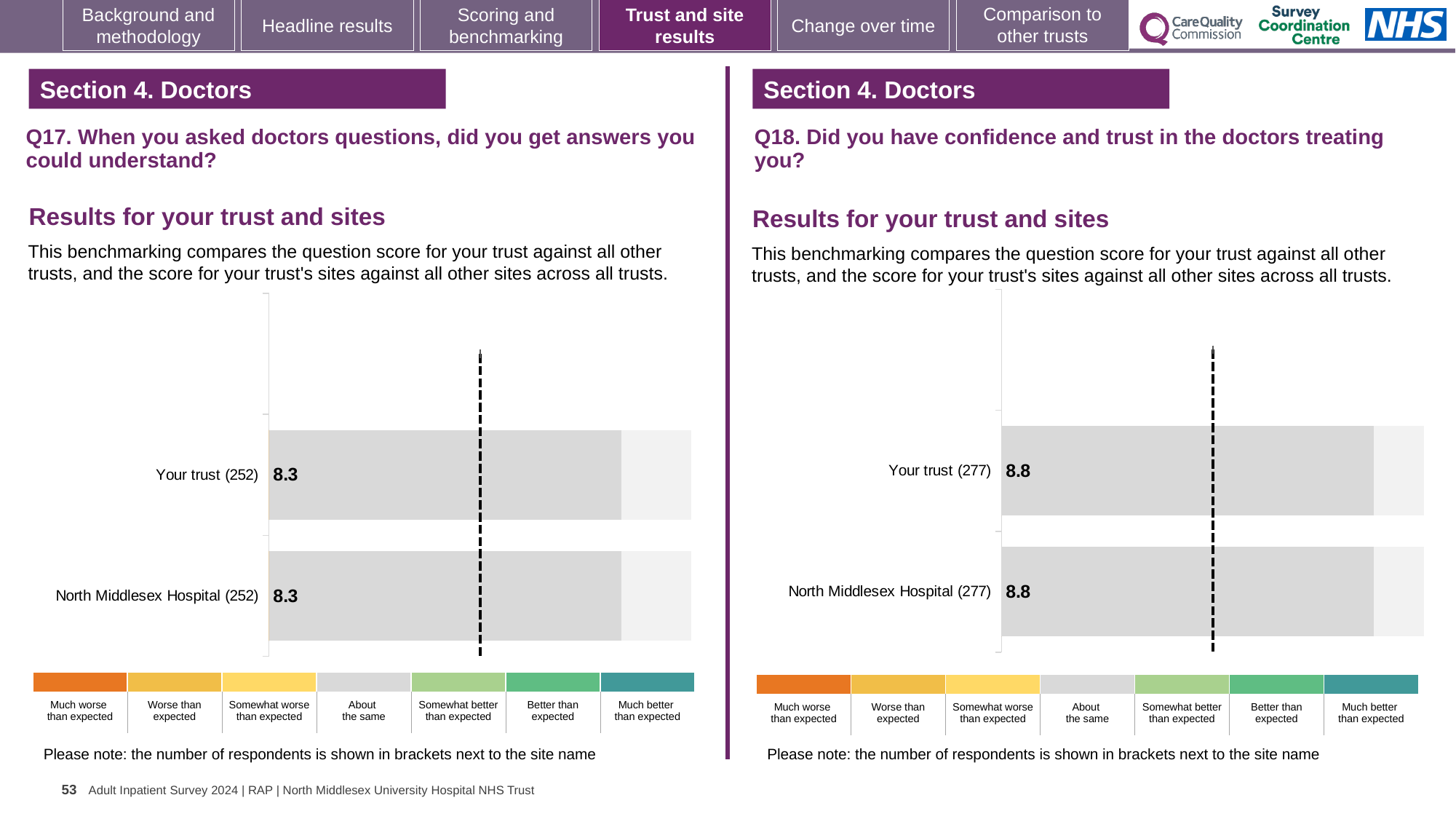
On the Q17 chart (left), how many respondents are shown in brackets for Your trust? 252 Is the Your trust score on the Q18 chart (right) larger or smaller than the Your trust score on the Q17 chart (left)? Larger On the Q17 chart (left), what is the difference between the Your trust score and the North Middlesex Hospital score? 0 How many bars are plotted on the Q18 chart (right)? 2 On the Q18 chart (right), what is the difference between the Your trust score and the North Middlesex Hospital score? 0 On the Q18 chart (right), how many respondents are shown in brackets for North Middlesex Hospital? 277 On the Q18 chart (right), what is the score for North Middlesex Hospital? 8.8 On the Q17 chart (left), what is the score for Your trust? 8.3 How many bars are plotted on the Q17 chart (left)? 2 What kind of chart is used for the Q17 results on the left? Bar chart On the Q18 chart (right), what is the score for Your trust? 8.8 On the Q17 chart (left), what is the score for North Middlesex Hospital? 8.3